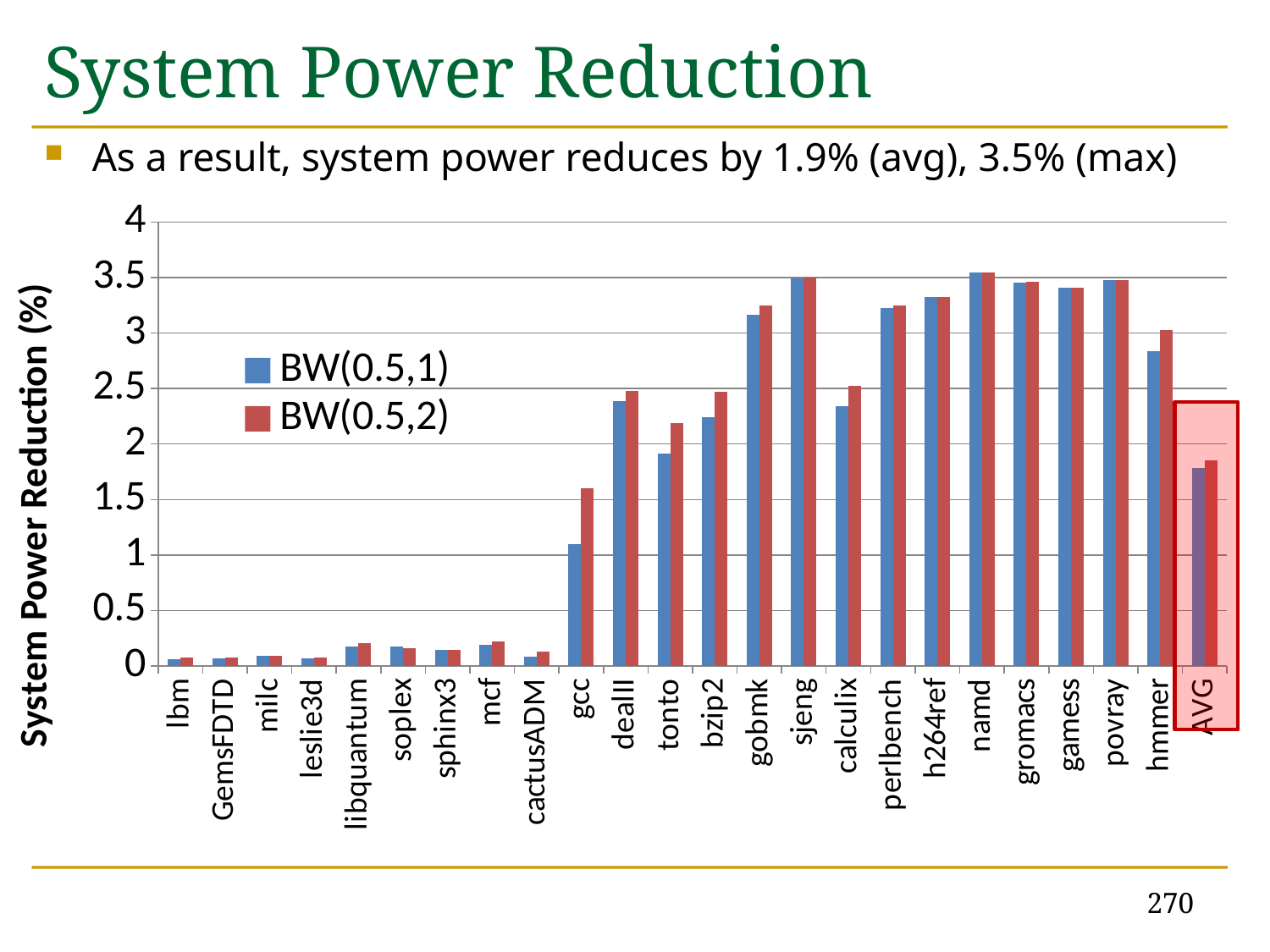
For the BW(0.5,1) series, which has the larger value, gcc or dealII? dealII Is the BW(0.5,1) value for lbm greater or less than 0.5? less What is the title of the y axis of the chart? System Power Reduction (%) For gcc, which series has the larger value, BW(0.5,1) or BW(0.5,2)? BW(0.5,2) Is the BW(0.5,1) value for tonto greater or less than 2? less What kind of chart is shown on the slide? bar chart How many categories are shown along the x axis of the chart? 24 Is the BW(0.5,1) value for hmmer greater or less than 3? less What are the two series named in the chart legend? BW(0.5,1) and BW(0.5,2) How many series does the chart legend list? 2